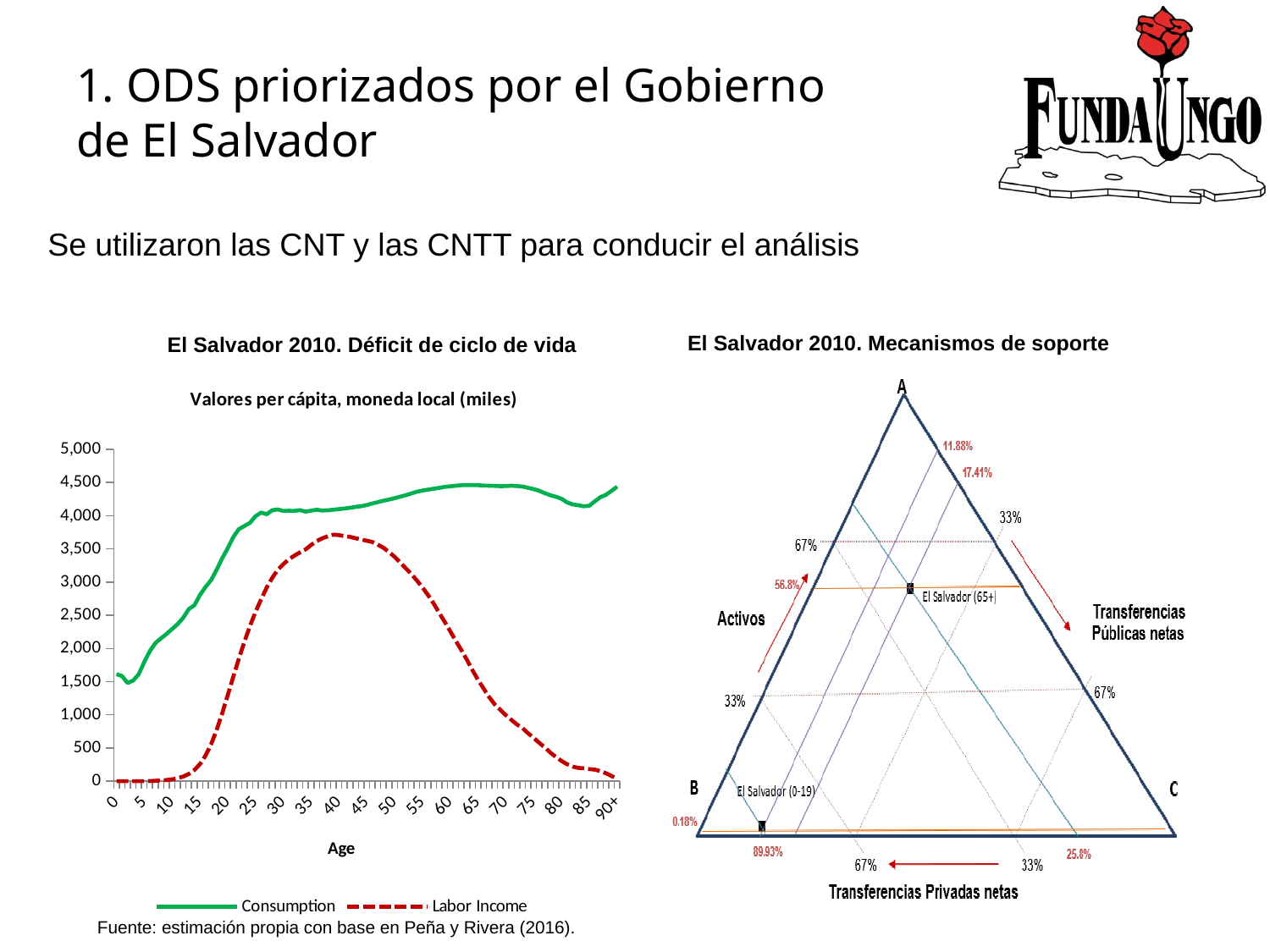
What kind of chart is 'El Salvador 2010. Déficit de ciclo de vida'? line chart In 'El Salvador 2010. Déficit de ciclo de vida', which series has the higher value at age 40, Consumption or Labor Income? Consumption In 'El Salvador 2010. Déficit de ciclo de vida', is the Consumption value at age 0 greater or less than 1,000? greater In 'El Salvador 2010. Déficit de ciclo de vida', is the Consumption value at age 65 greater or less than 4,000? greater In 'El Salvador 2010. Déficit de ciclo de vida', which series is drawn as a dashed red line? Labor Income In 'El Salvador 2010. Déficit de ciclo de vida', does Consumption rise or fall between age 5 and age 25? rise In 'El Salvador 2010. Déficit de ciclo de vida', does Labor Income rise or fall between age 40 and age 80? fall In 'El Salvador 2010. Déficit de ciclo de vida', is the Labor Income value at age 10 greater or less than 500? less How many El Salvador data points are plotted in 'El Salvador 2010. Mecanismos de soporte'? 2 What is the x-axis label of 'El Salvador 2010. Déficit de ciclo de vida'? Age How many series does the legend of 'El Salvador 2010. Déficit de ciclo de vida' list? 2